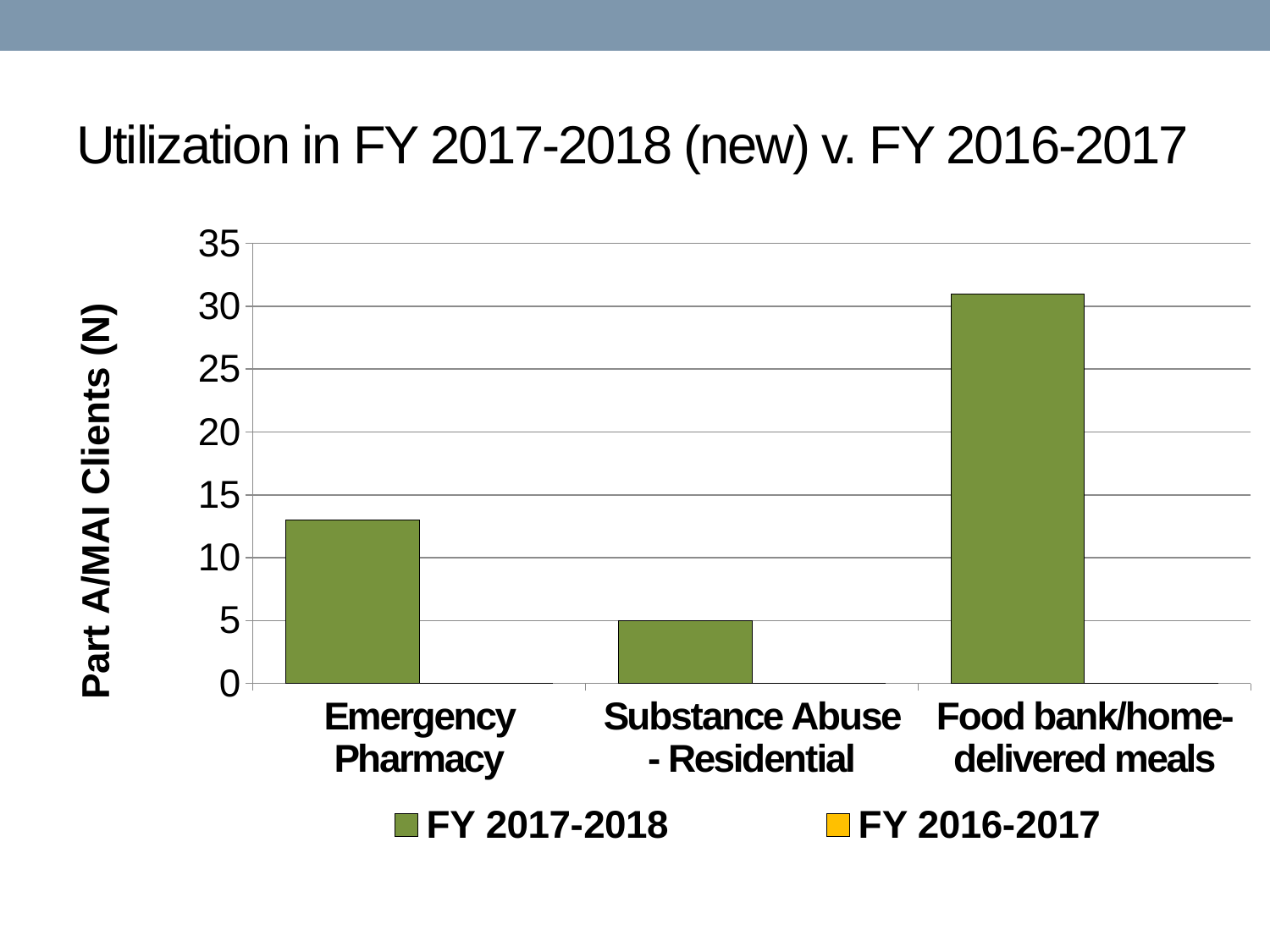
Which category has the highest number of Part A/MAI clients for FY 2017-2018? Food bank/home-delivered meals What kind of chart is shown on the slide? bar chart How many categories are shown on the x axis? 3 Which has a larger FY 2017-2018 value, Emergency Pharmacy or Substance Abuse - Residential? Emergency Pharmacy How many series does the legend list? 2 What is the FY 2017-2018 value for Substance Abuse - Residential? 5 Is the FY 2017-2018 value for Emergency Pharmacy greater or less than 15? less What is the label on the y axis? Part A/MAI Clients (N) What is the title of the chart? Utilization in FY 2017-2018 (new) v. FY 2016-2017 Which category has the lowest number of Part A/MAI clients for FY 2017-2018? Substance Abuse - Residential Is the FY 2017-2018 value for Emergency Pharmacy greater or less than 10? greater Is the FY 2017-2018 value for Food bank/home-delivered meals greater or less than 25? greater